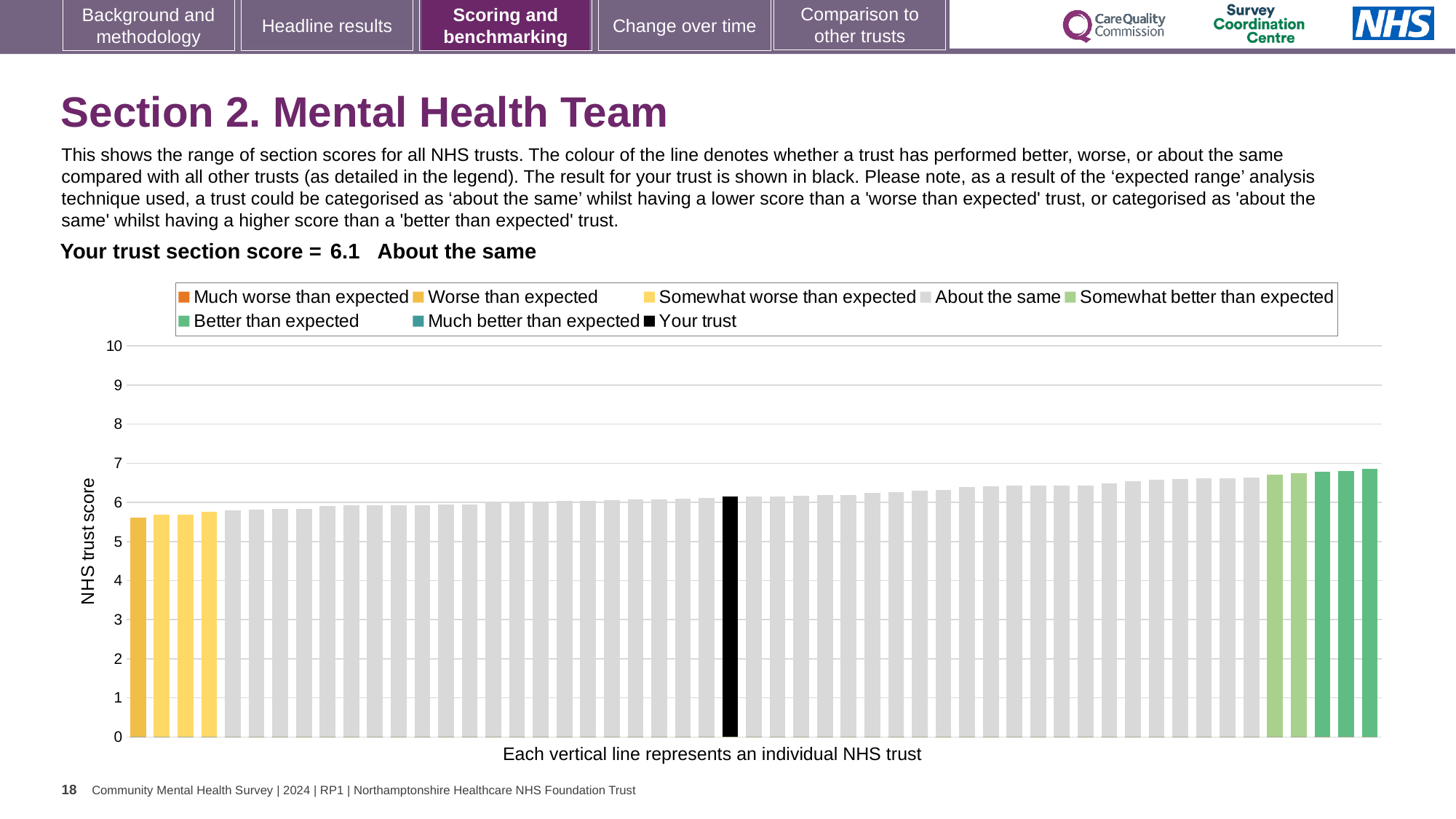
How many entries does the chart legend list? 8 What colour is used for the 'Your trust' bar in the chart? black What kind of chart is used to show the range of section scores? bar chart Is the value of the rightmost bar greater or less than 7? less What is the section score for your trust shown on the slide? 6.1 Is the value of the leftmost bar greater or less than 6? less What is the label on the vertical axis of the chart? NHS trust score Which category is your trust placed in according to the text above the chart? About the same What is the highest value shown on the vertical axis of the chart? 10 Is the value of the black bar (your trust) greater or less than 6? greater Do the bar values rise or fall from left to right along the x axis? rise